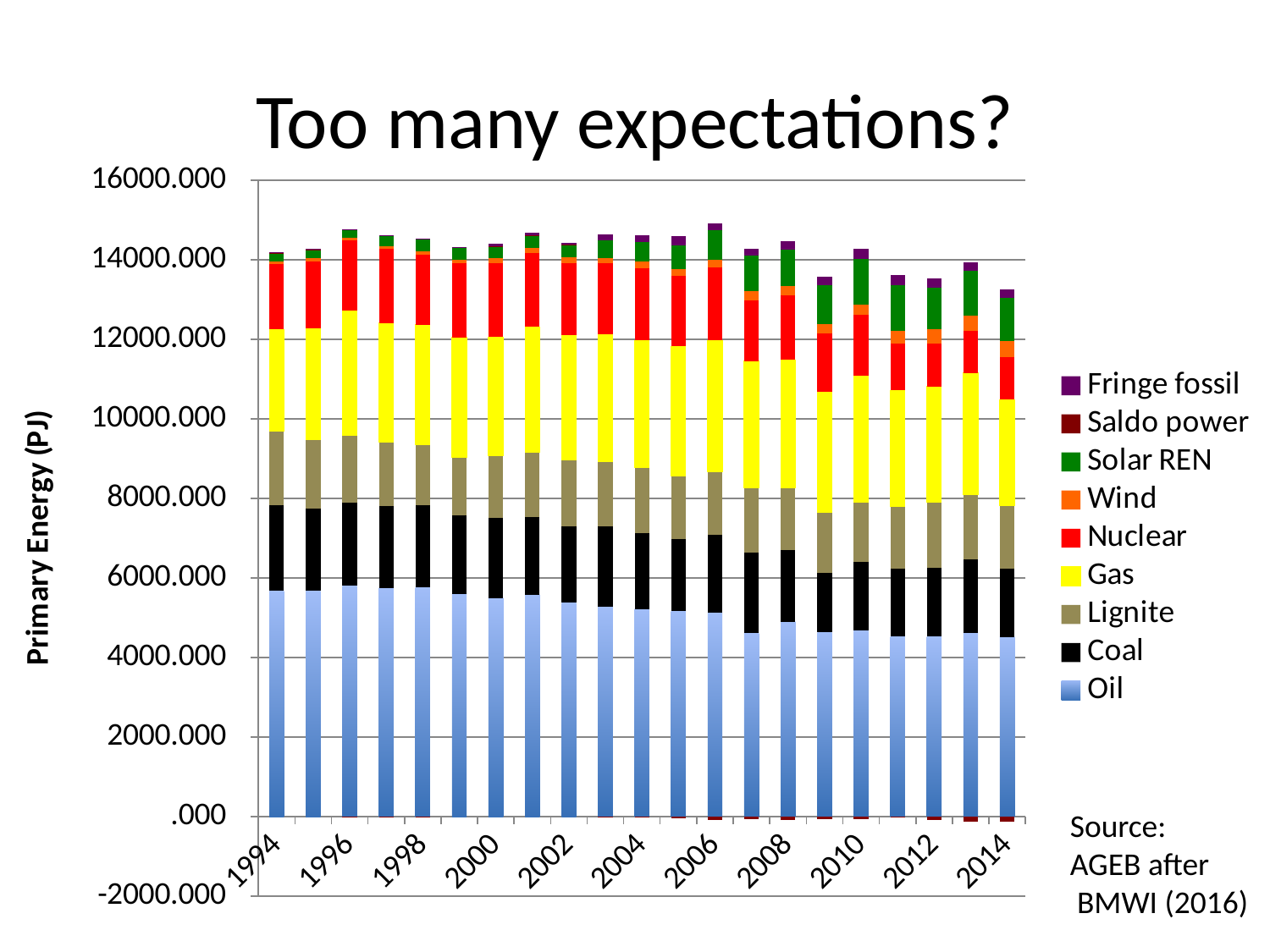
Is the total height of the stacked bar for 1994 greater or less than 12000? greater What is the label of the y axis? Primary Energy (PJ) Does the total primary energy (total bar height) generally rise or fall from 1994 to 2014? fall How many series does the legend list? 9 Is the Oil value for 2014 greater or less than 6000? less Which is larger, the Oil segment in 1994 or the Oil segment in 2014? 1994 How many years (bars) are plotted along the x axis? 21 Is the total height of the stacked bar for 2014 greater or less than 14000? less What is the title of the chart? Too many expectations? Which is larger, the Solar REN segment in 1994 or the Solar REN segment in 2014? 2014 What kind of chart is shown on the slide? Stacked bar chart